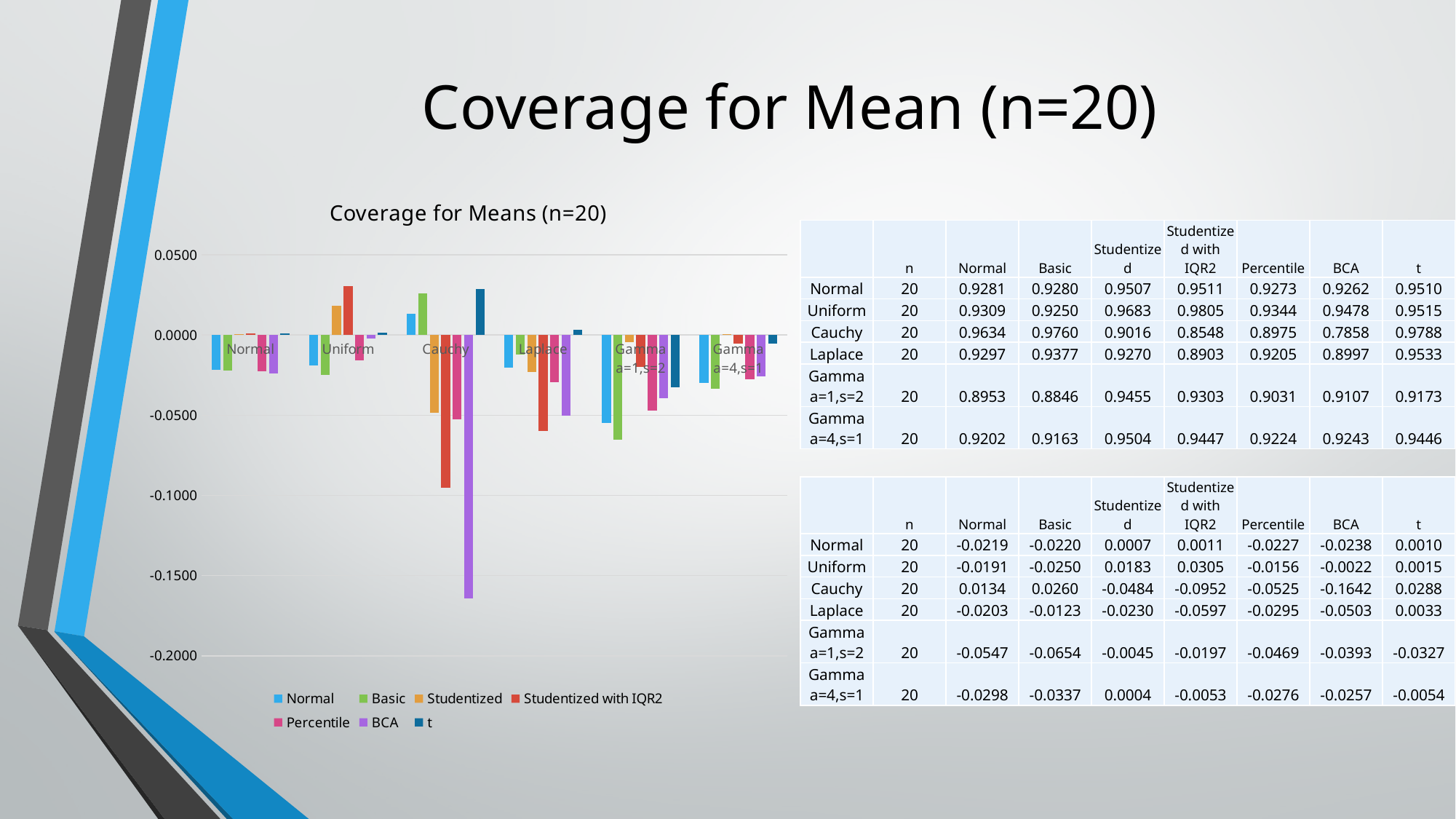
According to the lower table, what is the BCA value for Cauchy plotted in the chart? -0.1642 Is the BCA value for Cauchy greater or less than -0.1500? less What kind of chart is shown on the slide? bar chart What is the title of the chart? Coverage for Means (n=20) How many distribution categories are shown along the x axis of the chart? 6 Which category and series has the lowest bar in the chart? BCA for Cauchy Is the Studentized with IQR2 value for Cauchy greater or less than -0.0500? less According to the lower table, what is the Studentized with IQR2 value for Cauchy plotted in the chart? -0.0952 Is the Basic value for Gamma a=1,s=2 greater or less than -0.0500? less What colour represents the BCA series in the chart legend? purple For Cauchy, which is lower: the Studentized with IQR2 bar or the BCA bar? BCA How many series does the chart legend list? 7